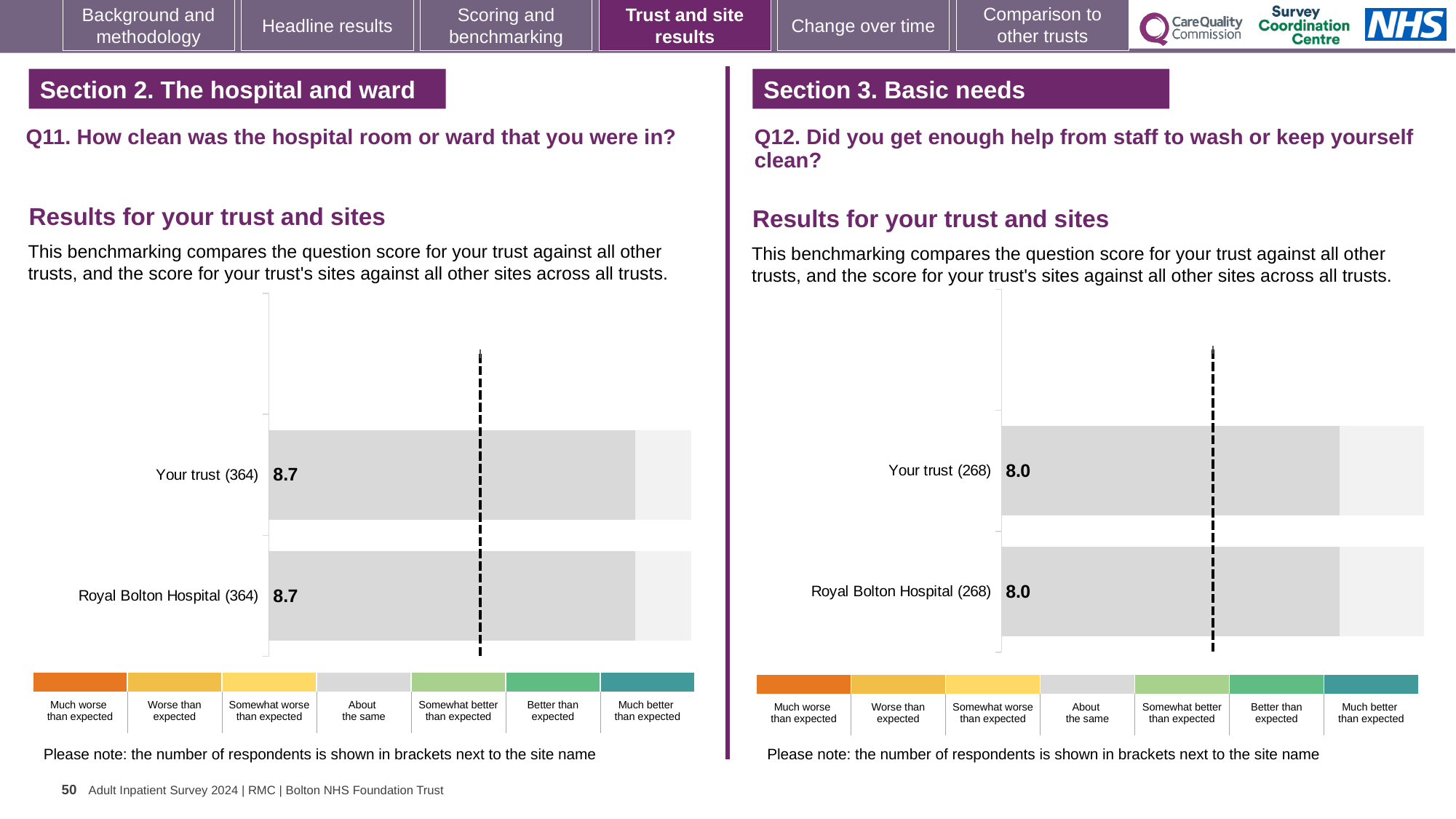
In the Q11 chart on the left, what is the score for Your trust? 8.7 In the Q12 chart on the right, how many respondents are shown in brackets next to Royal Bolton Hospital? 268 How many bars are plotted in the Q11 chart on the left? 2 What kind of chart is used for the Q11 results on the left? Bar chart In the Q12 chart on the right, what is the score for Your trust? 8.0 How many bars are plotted in the Q12 chart on the right? 2 In the Q11 chart on the left, what is the score for Royal Bolton Hospital? 8.7 In the Q11 chart on the left, what is the difference between the score for Your trust and the score for Royal Bolton Hospital? 0.0 In the Q12 chart on the right, what is the score for Royal Bolton Hospital? 8.0 Is the score for Your trust in the Q12 chart on the right greater or less than the score for Your trust in the Q11 chart on the left? less In the Q11 chart on the left, how many respondents are shown in brackets next to Your trust? 364 In the Q12 chart on the right, what is the difference between the score for Your trust and the score for Royal Bolton Hospital? 0.0